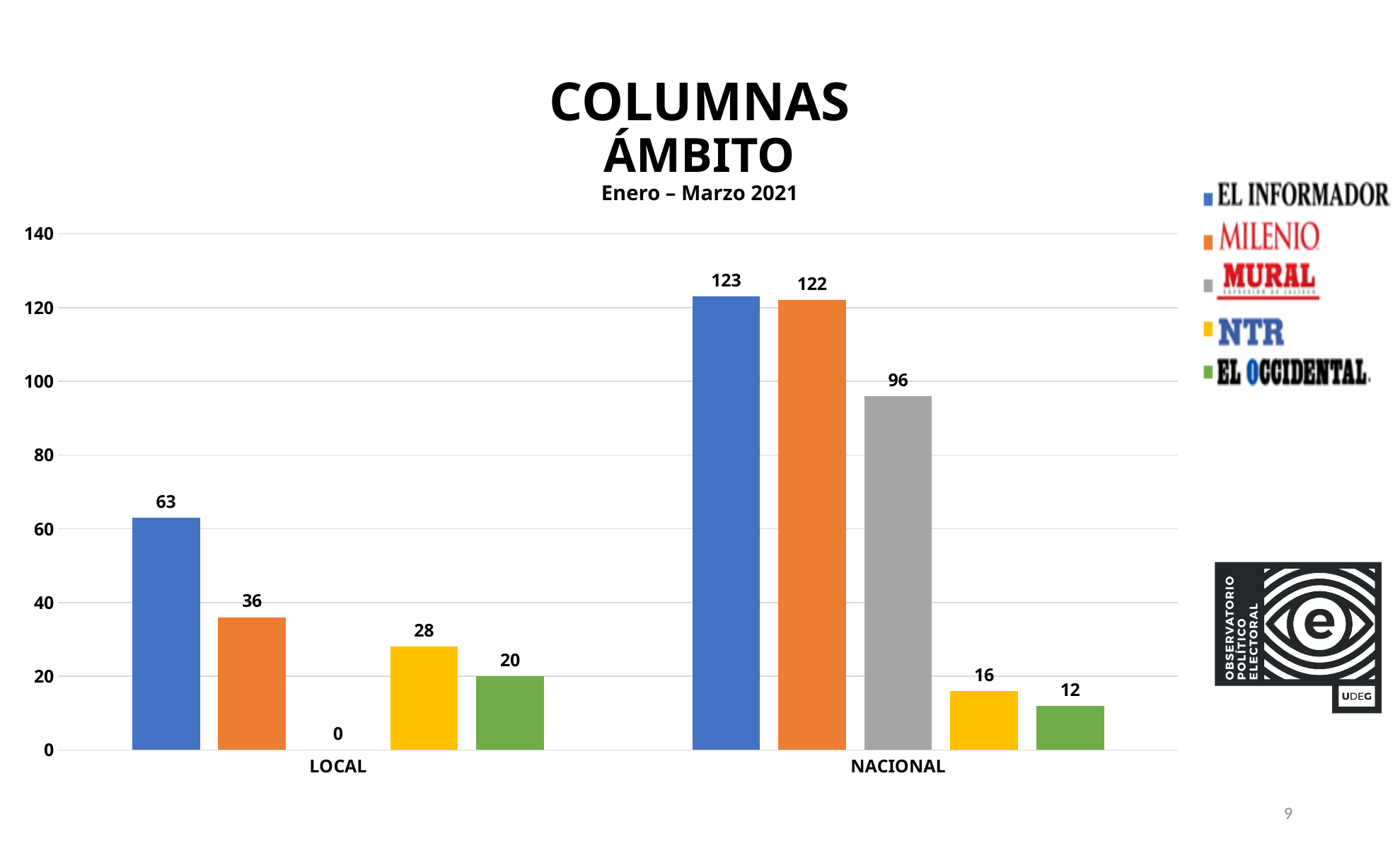
Which series has the highest value in the NACIONAL category? El Informador What period is shown in the chart subtitle? Enero – Marzo 2021 What is the value for El Occidental in the NACIONAL category? 12 How many series does the legend list? 5 What is the value for Mural in the NACIONAL category? 96 What is the value for NTR in the LOCAL category? 28 What kind of chart is shown on the slide? Bar chart Which series has the lowest value in the LOCAL category? Mural What is the difference between El Informador's NACIONAL value and its LOCAL value? 60 What is the value for El Informador in the LOCAL category? 63 Which is larger: Milenio's LOCAL value or NTR's LOCAL value? Milenio's LOCAL value How many categories are shown on the x axis? 2